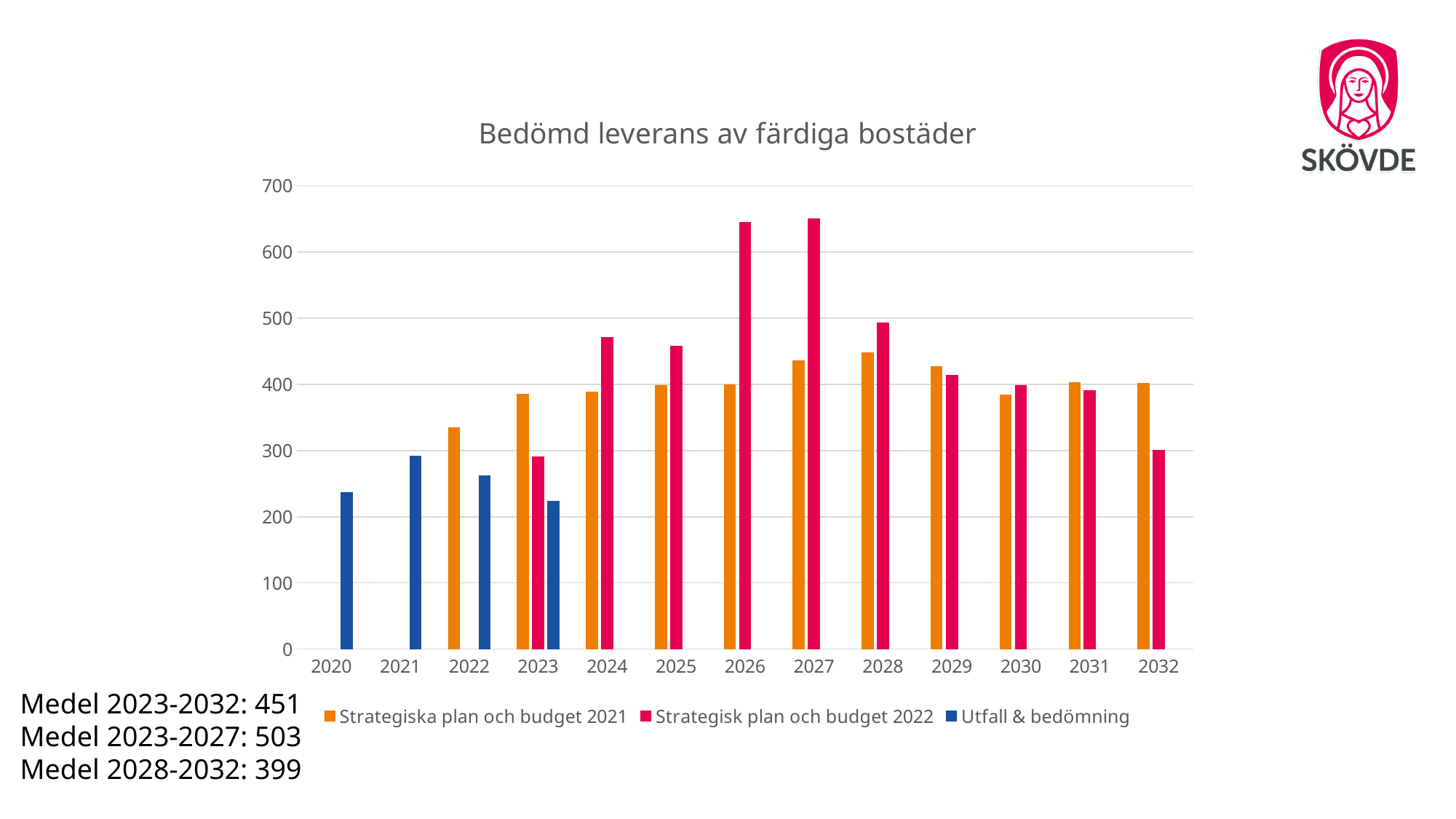
Is the value for Strategisk plan och budget 2022 in 2024 greater or less than 400? greater Which colour represents the Utfall & bedömning series? Blue What kind of chart is shown on the slide? Bar chart Is the value for Strategisk plan och budget 2022 in 2026 greater or less than 600? greater Is the value for Strategiska plan och budget 2021 in 2022 greater or less than 300? greater How many series does the legend list? 3 How many years are shown on the x axis? 13 In 2026, which series has the larger value: Strategiska plan och budget 2021 or Strategisk plan och budget 2022? Strategisk plan och budget 2022 In 2032, which series has the larger value: Strategiska plan och budget 2021 or Strategisk plan och budget 2022? Strategiska plan och budget 2021 In 2023, which is larger: Strategiska plan och budget 2021 or Utfall & bedömning? Strategiska plan och budget 2021 What is the title of the chart? Bedömd leverans av färdiga bostäder